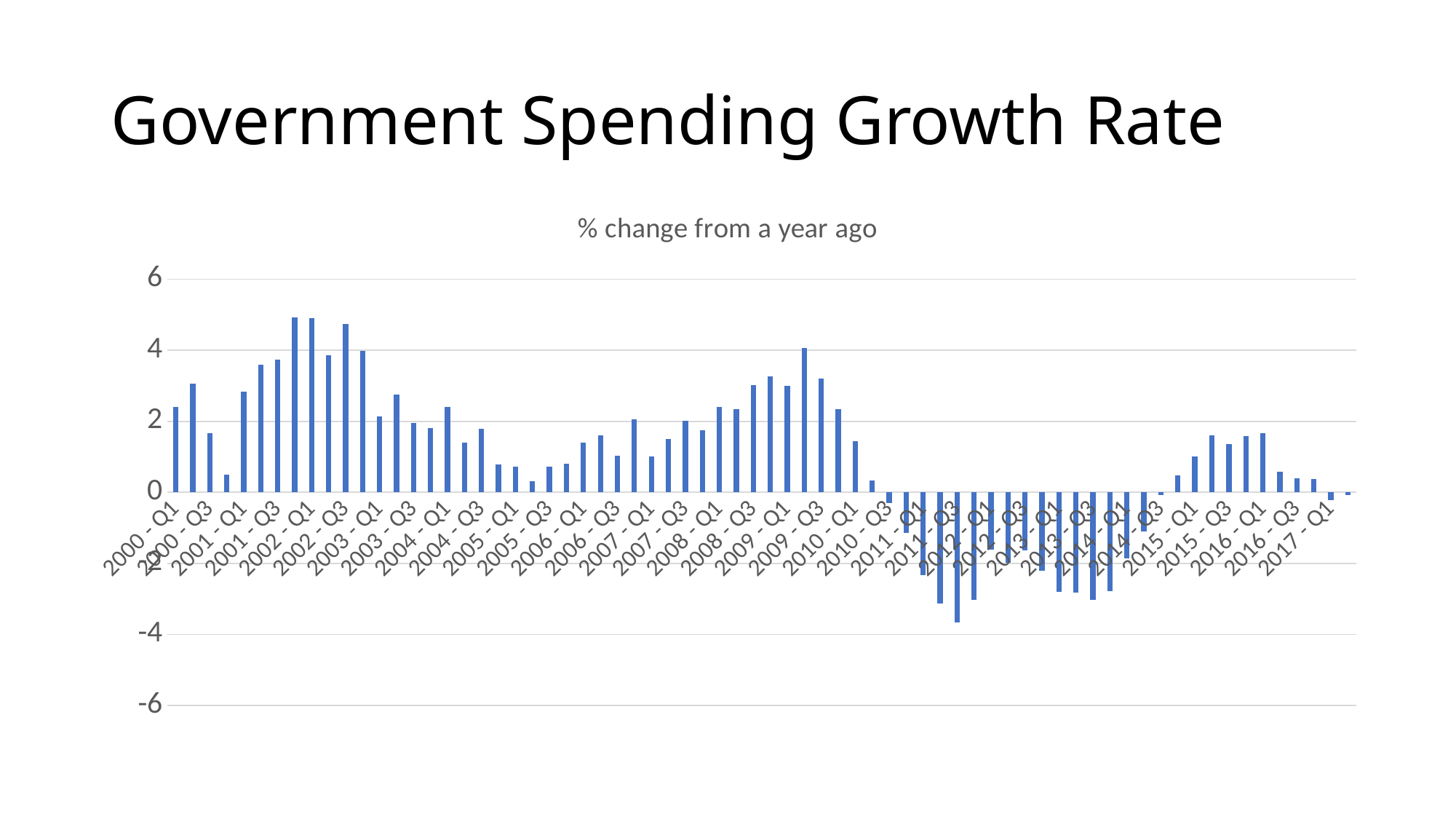
Which is larger, the value for 2009 - Q3 or the value for 2008 - Q3? 2009 - Q3 Do the values generally rise or fall from 2009 - Q3 to 2011 - Q1? fall Which quarter has the lowest value in the chart? 2011 - Q3 Is the value for 2005 - Q3 greater or less than 2? less Is the value for 2002 - Q1 greater or less than 4? greater Which is larger, the value for 2000 - Q3 or the value for 2000 - Q1? 2000 - Q1 Is the value for 2009 - Q3 greater or less than 2? greater What kind of chart is shown on the slide? bar chart Do the values generally rise or fall from 2000 - Q1 to 2002 - Q1? rise What is the title shown above the chart? % change from a year ago